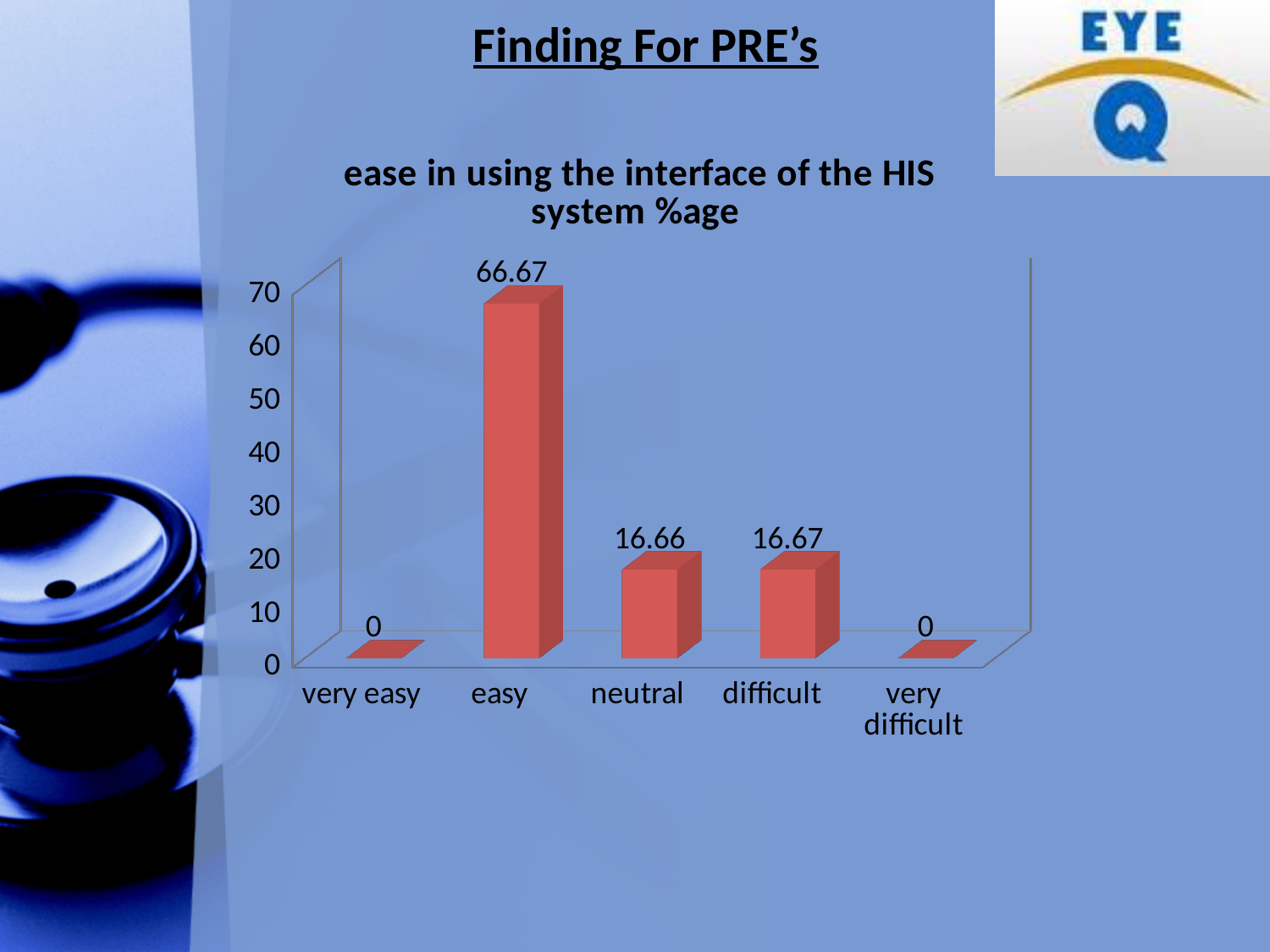
What is the value for 'easy'? 66.67 What is the value for 'very easy'? 0 Is the value for 'easy' greater or less than 60? greater Which is larger, the value for 'easy' or the value for 'neutral'? easy What is the value for 'neutral'? 16.66 What is the title of the chart? ease in using the interface of the HIS system %age What kind of chart is shown on the slide? bar chart How many categories have a value of 0? 2 Which category has the highest value? easy What is the difference between the values for 'easy' and 'difficult'? 50 How many categories are shown on the x axis? 5 What is the value for 'difficult'? 16.67